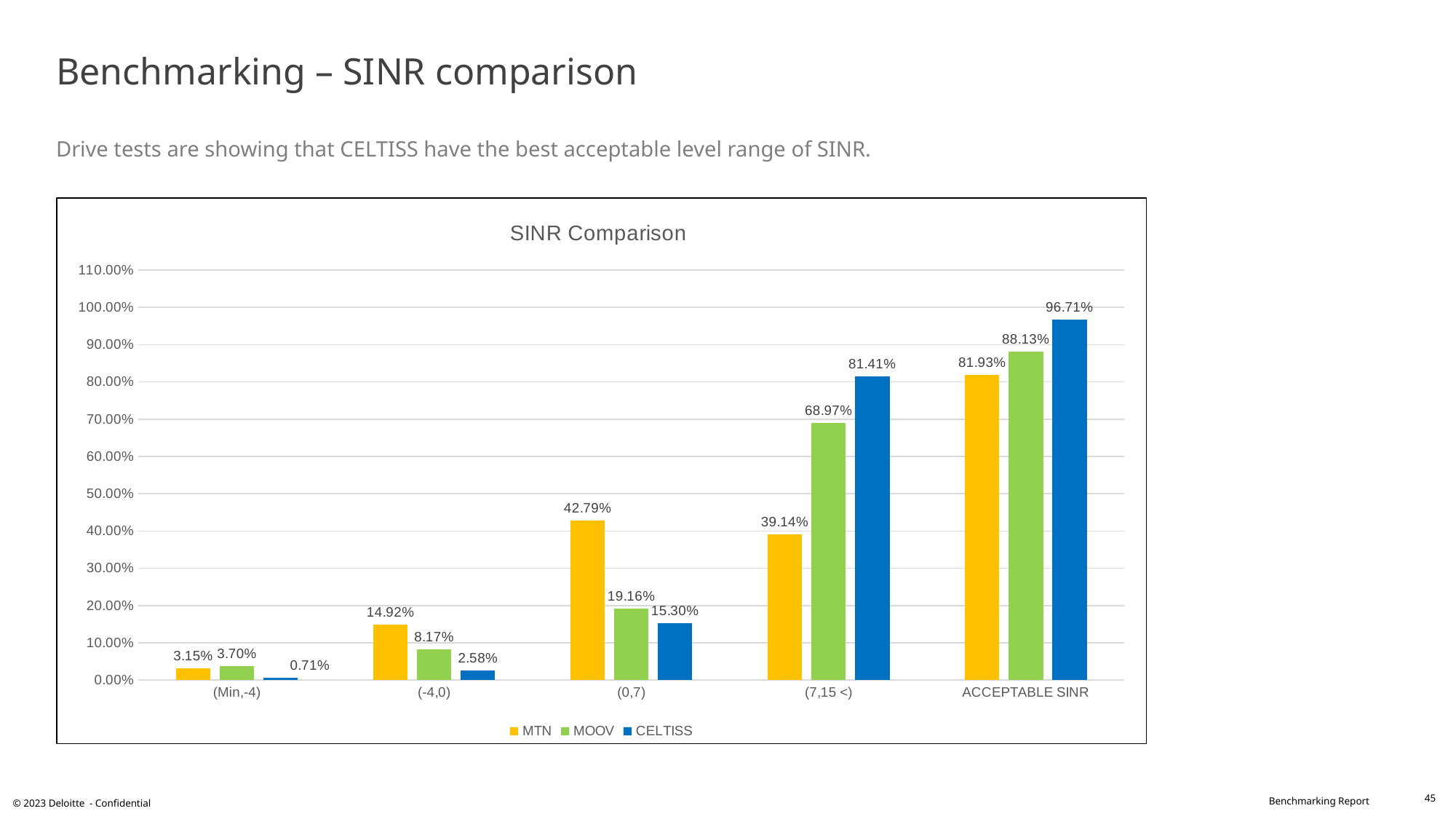
What is the value for MTN in the (0,7) category? 42.79% How many categories are shown on the x axis? 5 What is the value for CELTISS in the ACCEPTABLE SINR category? 96.71% What is the value for MOOV in the (7,15 <) category? 68.97% Which is larger in the (0,7) category: the MOOV value or the CELTISS value? MOOV How many series does the legend list? 3 What is the title of the chart? SINR Comparison Which series has the highest value in the ACCEPTABLE SINR category? CELTISS What kind of chart is shown on the slide? Bar chart Which series has the lowest value in the (-4,0) category? CELTISS What is the difference between the CELTISS and MTN values in the ACCEPTABLE SINR category? 14.78% What is the value for CELTISS in the (Min,-4) category? 0.71%